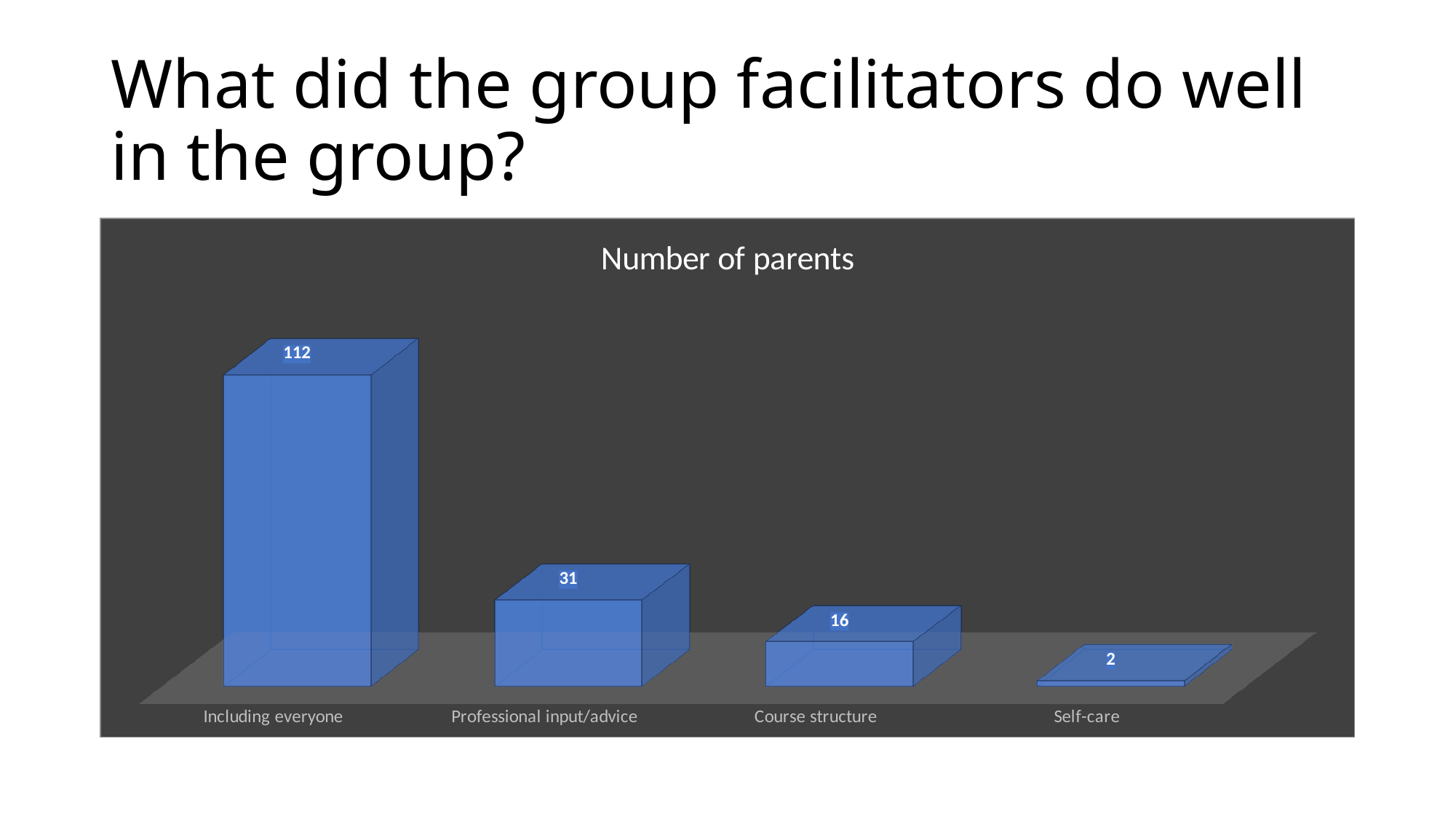
What is the difference between the number of parents for Course structure and Self-care? 14 What is the number of parents for Professional input/advice? 31 What is the number of parents for Including everyone? 112 Which category has the lowest number of parents? Self-care What kind of chart is shown on the slide? Bar chart What is the title of the chart? Number of parents Which category has the highest number of parents? Including everyone What is the difference between the number of parents for Including everyone and Professional input/advice? 81 How many categories are shown in the chart? 4 What is the number of parents for Course structure? 16 Which has more parents, Professional input/advice or Course structure? Professional input/advice What is the number of parents for Self-care? 2